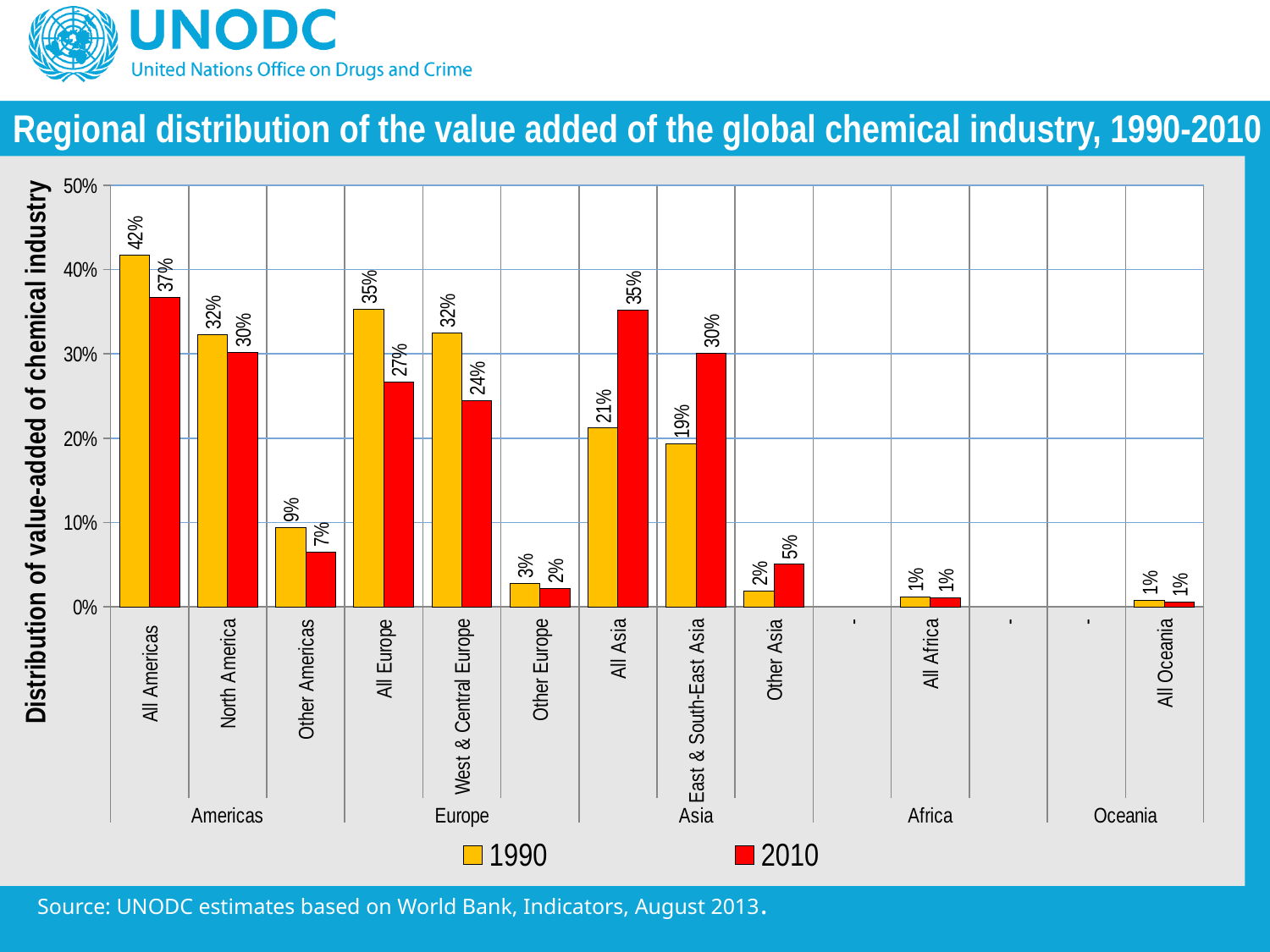
What was the value for All Americas in 1990? 42% What kind of chart is shown on the slide? Bar chart Which colour represents the 2010 series in the chart? Red Did the value for Other Asia rise or fall from 1990 to 2010? Rise Which region had the lowest value in 2010? All Africa and All Oceania (both 1%) Which region had the highest value in 1990? All Americas How many series does the legend list? 2 What was the value for West & Central Europe in 2010? 24% What was the value for All Asia in 2010? 35% Which is larger for All Asia: the 1990 value or the 2010 value? 2010 What was the value for East & South-East Asia in 1990? 19% What is the difference between the 1990 and 2010 values for All Europe? 8%